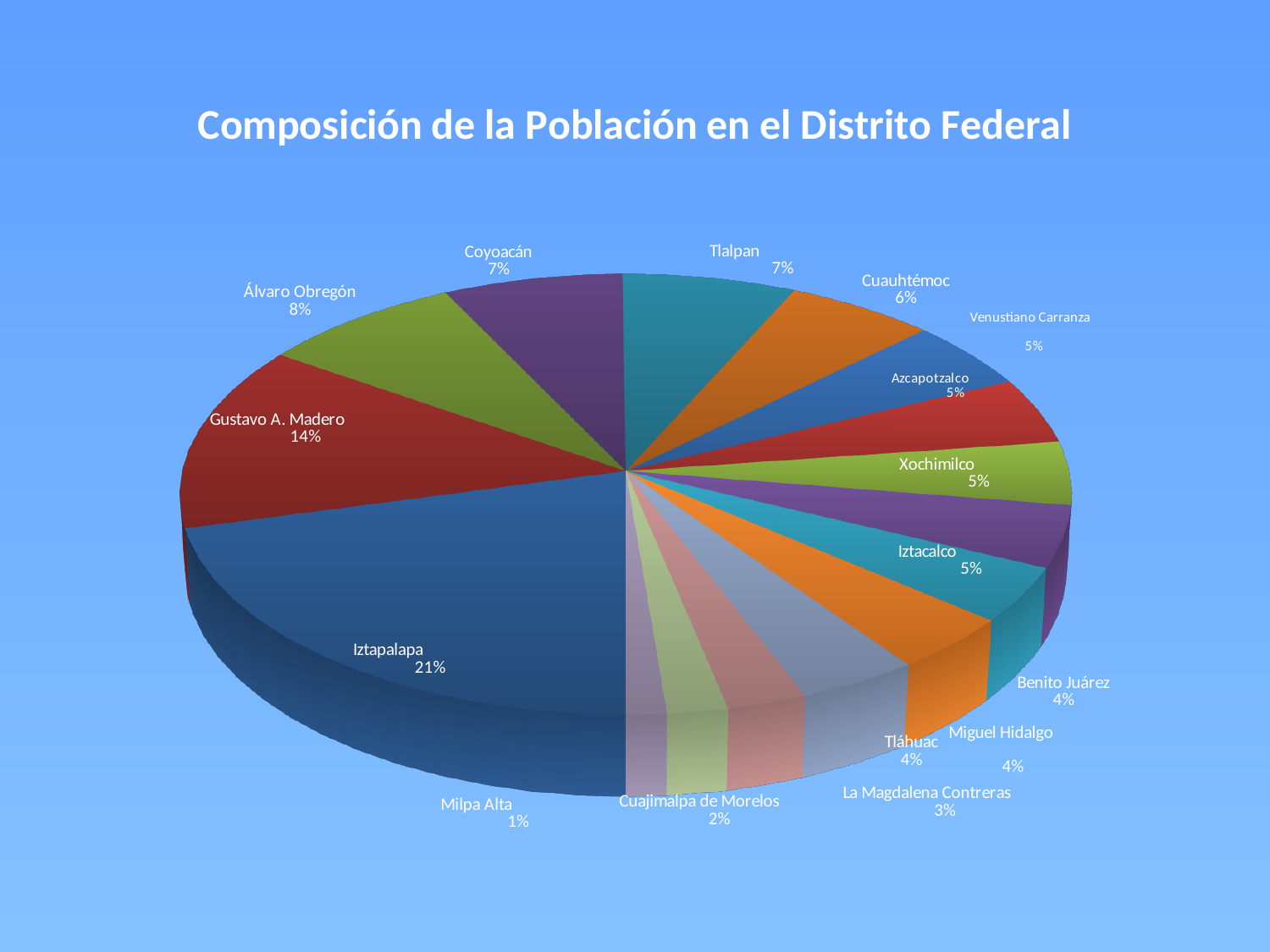
How many delegaciones (slices) are shown in the pie chart? 16 What is the combined share of Coyoacán and Tlalpan? 14% What is the title of the chart? Composición de la Población en el Distrito Federal Which is larger, the share for Cuauhtémoc or the share for La Magdalena Contreras? Cuauhtémoc Which delegación has the largest slice of the pie? Iztapalapa What percentage is shown for Cuajimalpa de Morelos? 2% What is the difference in percentage points between Iztapalapa and Gustavo A. Madero? 7 Which delegación has the smallest slice of the pie? Milpa Alta What percentage is shown for Álvaro Obregón? 8% What kind of chart is shown on the slide? Pie chart What share of the population does Iztapalapa represent? 21% What percentage is shown for Gustavo A. Madero? 14%